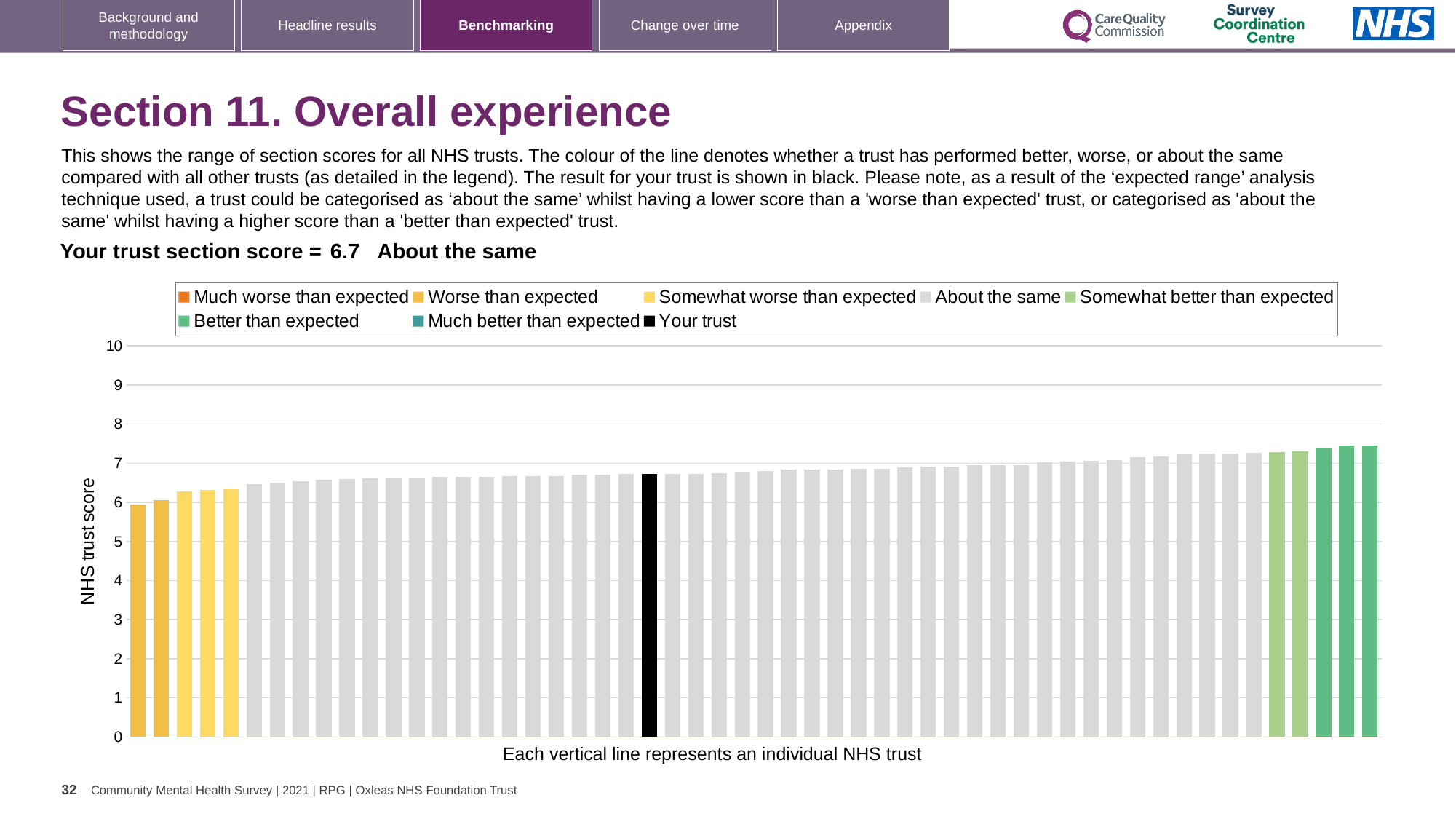
How many bars are coloured as 'Better than expected'? 3 Is the value of the highest bar greater or less than 8? less What is the label on the vertical axis? NHS trust score Do the bar values rise or fall from left to right along the x axis? rise How many entries does the chart legend list? 8 What is the section score for your trust? 6.7 Is the value for your trust greater or less than 5? greater What kind of chart is shown on the slide? bar chart Which category is your trust placed in for this section? About the same Is the value of the lowest bar greater or less than 5? greater What colour is the bar for your trust? black